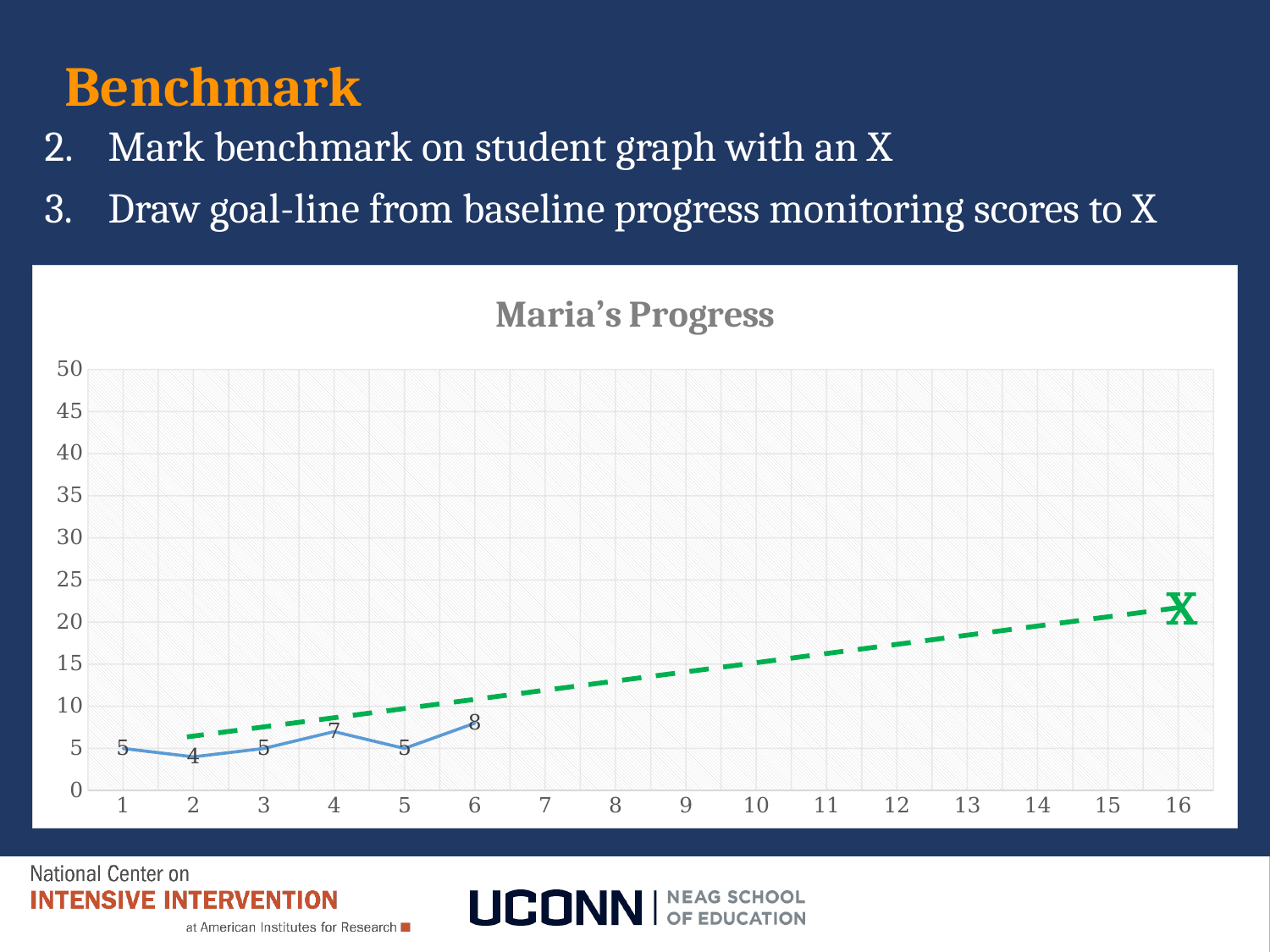
What is the title of the chart on the slide? Maria's Progress Which is larger, Maria's score at point 4 or her score at point 5? point 4 What is Maria's score at point 2? 4 What is Maria's score at point 4? 7 How many data points are plotted on Maria's progress line? 6 Is the benchmark X at point 16 greater or less than 15? greater What is the difference between Maria's score at point 6 and her score at point 2? 4 What is Maria's score at point 1? 5 At which point is Maria's highest plotted score? 6 At which point is Maria's lowest plotted score? 2 What is Maria's score at point 6? 8 What type of chart is shown on the slide? line chart